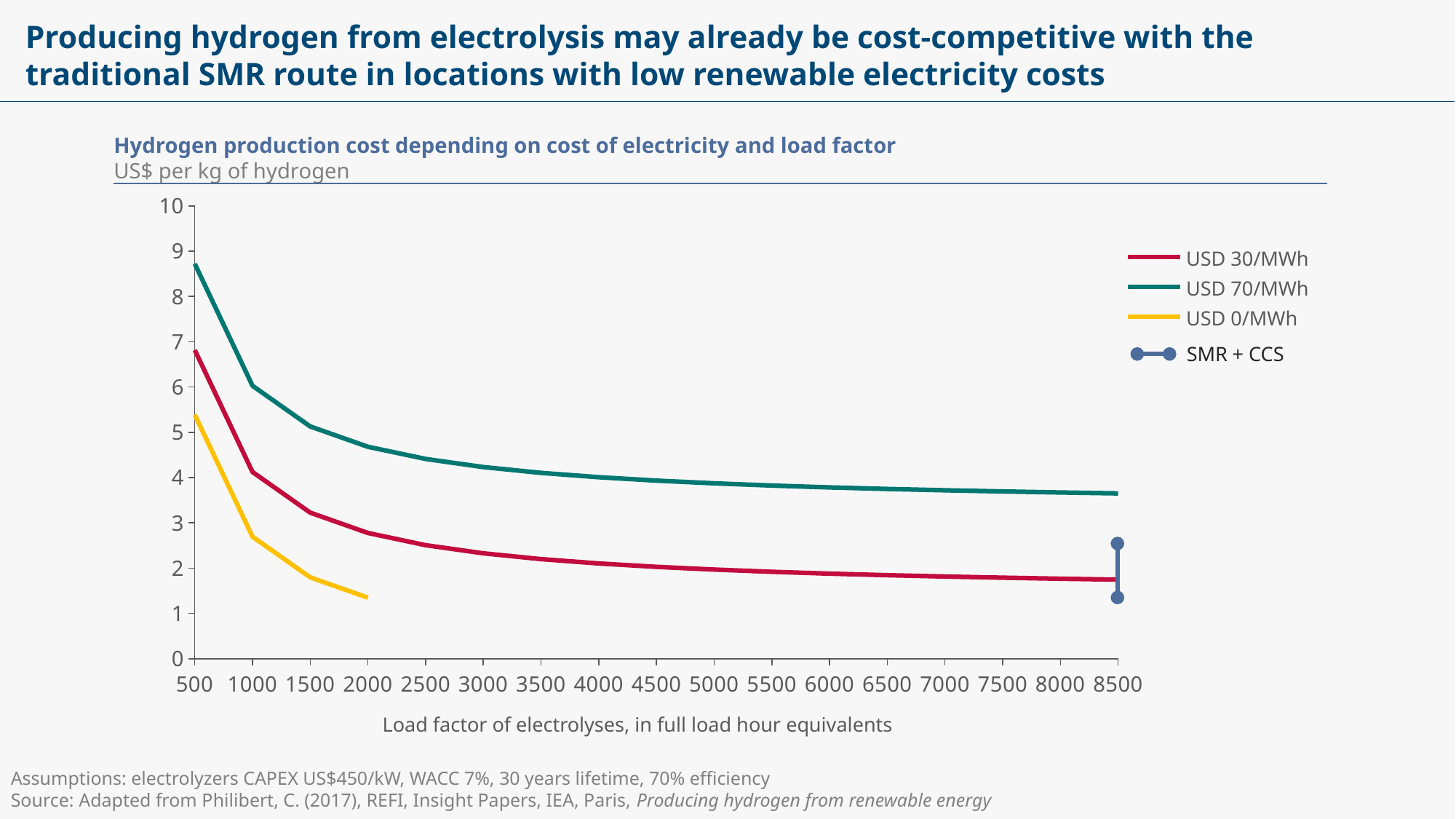
What is the label of the x axis? Load factor of electrolyses, in full load hour equivalents How many entries does the chart legend list? 4 Is the value of the USD 30/MWh line at a load factor of 500 greater or less than 6? greater What kind of chart is shown on the slide? line chart Is the value of the USD 70/MWh line at a load factor of 8500 greater or less than 4? less Is the value of the USD 30/MWh line at a load factor of 8500 greater or less than 2? less What is the title of the chart? Hydrogen production cost depending on cost of electricity and load factor Which electricity-cost series shows the highest hydrogen production cost at a load factor of 500? USD 70/MWh At a load factor of 1000, which line is higher: USD 70/MWh or USD 30/MWh? USD 70/MWh Does the USD 70/MWh line rise or fall as the load factor increases along the x axis? fall